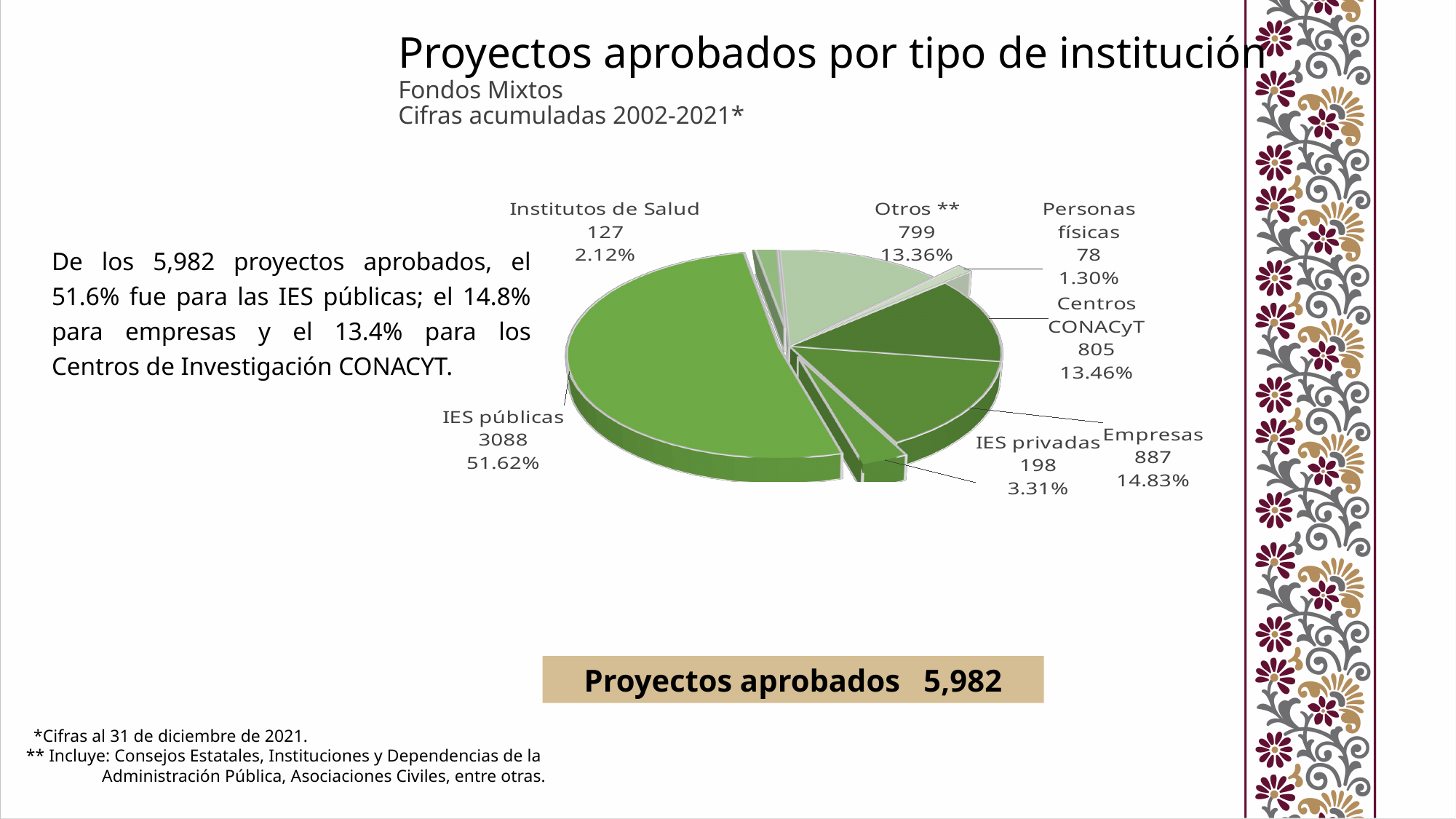
What is the difference in approved projects between Empresas and Centros CONACyT? 82 What is the title of the slide's chart? Proyectos aprobados por tipo de institución How many projects were approved for IES públicas? 3088 What kind of chart is shown on the slide? pie chart How many projects were approved for Centros CONACyT? 805 How many categories are shown in the pie chart? 7 Which category has the largest slice of the pie? IES públicas What percentage of the pie corresponds to Personas físicas? 1.30% What share of the pie does Empresas represent? 14.83% Which category has the smallest slice of the pie? Personas físicas What is the total number of approved projects shown on the slide? 5,982 Which has more approved projects, IES privadas or Institutos de Salud? IES privadas